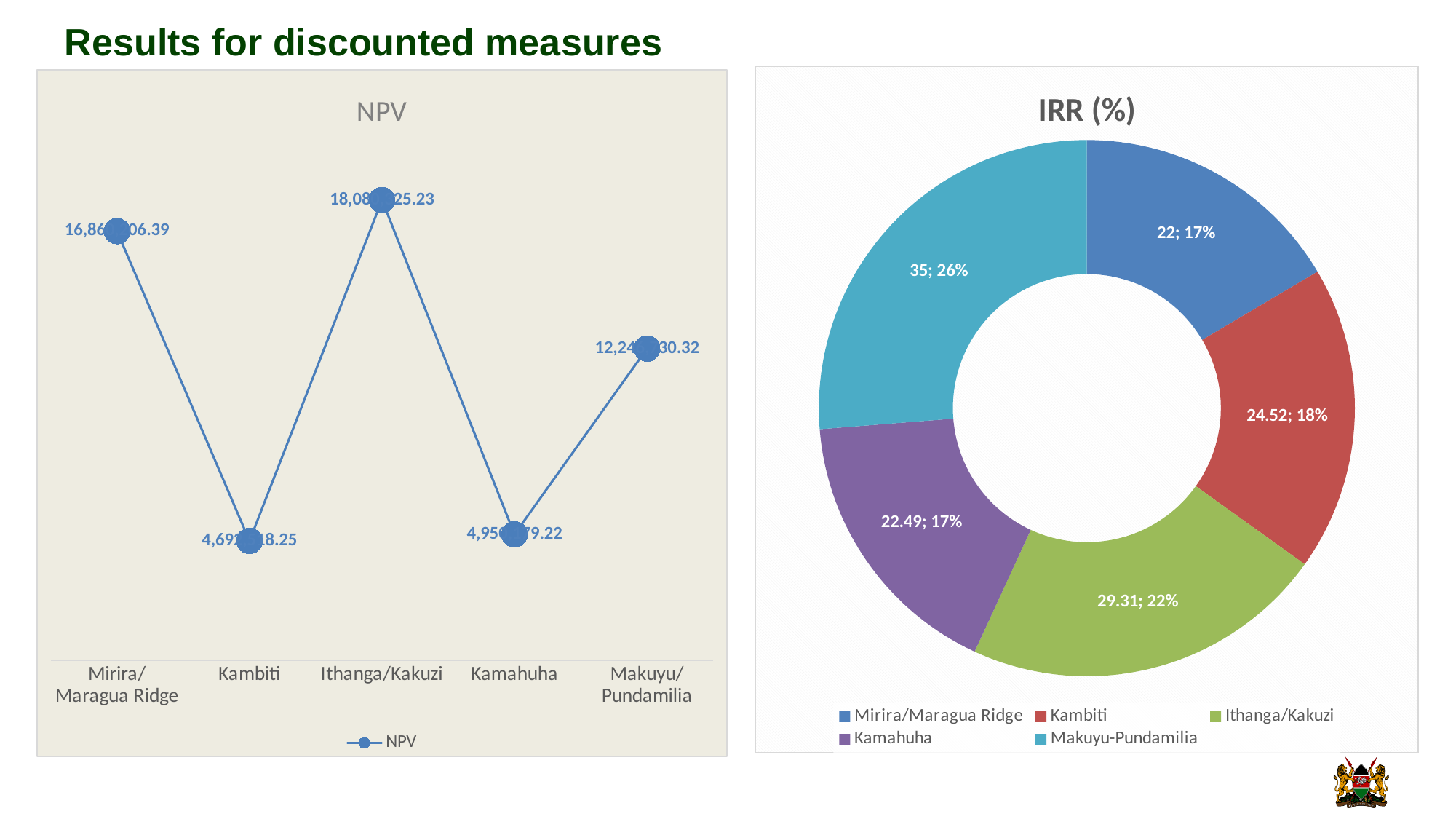
What kind of chart is the IRR (%) chart? Doughnut chart In the NPV chart, which category has the highest NPV? Ithanga/Kakuzi How many categories does the legend of the IRR (%) chart list? 5 In the IRR (%) chart, what is the value for Makuyu-Pundamilia? 35 What kind of chart is the NPV chart? Line chart In the IRR (%) chart, which category has the highest value? Makuyu-Pundamilia In the IRR (%) chart, what is the value for Kamahuha? 22.49 How many categories are plotted in the NPV chart? 5 In the NPV chart, which has the larger NPV, Mirira/Maragua Ridge or Makuyu/Pundamilia? Mirira/Maragua Ridge In the IRR (%) chart, what is the difference between the values for Kambiti and Kamahuha? 2.03 In the IRR (%) chart, what share of the pie does Ithanga/Kakuzi represent? 22% In the IRR (%) chart, which category has the lowest value? Mirira/Maragua Ridge